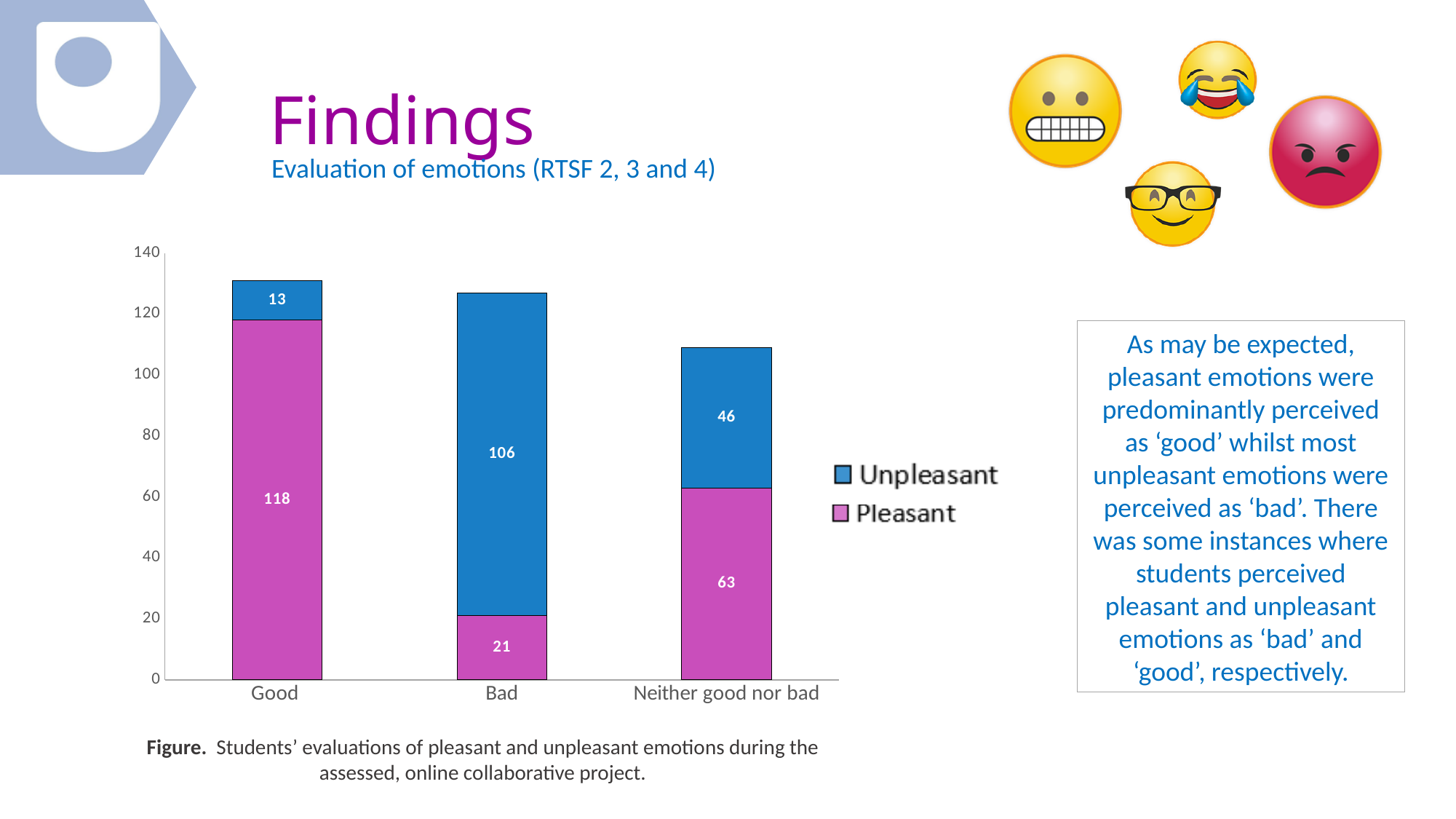
What is the Unpleasant value for the Bad category? 106 What is the total of the stacked bar for the Good category? 131 Which category has the highest Pleasant value? Good What is the total of the stacked bar for the Bad category? 127 Which category has the lowest Unpleasant value? Good Which is larger: the Unpleasant value for Bad or the Unpleasant value for Neither good nor bad? Bad What is the Pleasant value for the Bad category? 21 What is the Unpleasant value for the Neither good nor bad category? 46 What is the Pleasant value for the Good category? 118 What is the difference between the Pleasant values for Good and Neither good nor bad? 55 How many categories are shown on the x axis? 3 How many series does the legend list? 2